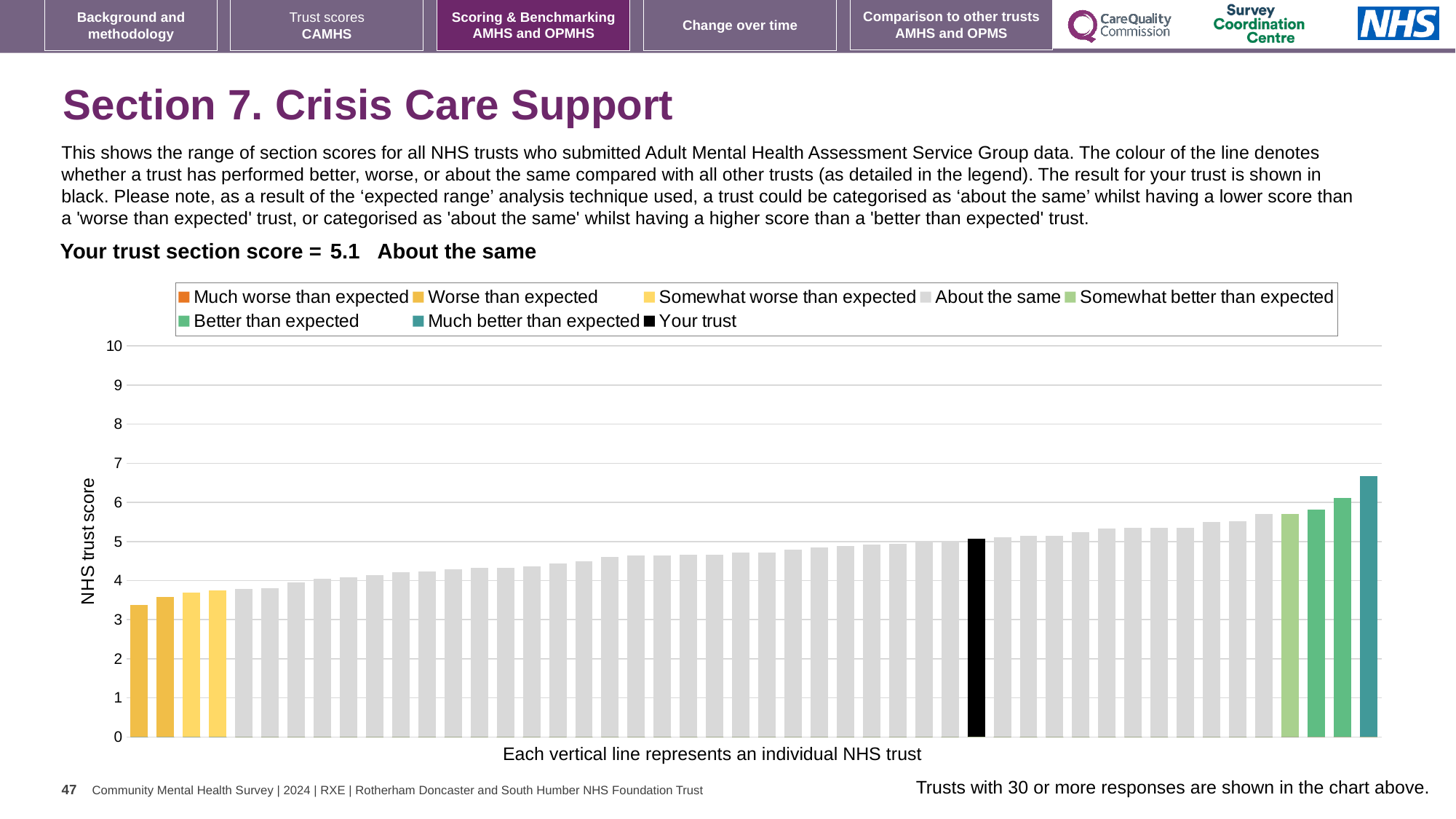
Do the bar values rise or fall from left to right across the chart? rise What is the trust's section score shown on the slide? 5.1 What is the highest value shown on the vertical axis? 10 How many bars in the chart are coloured black? 1 Is the value of the shortest bar greater or less than 4? less Is the value of the tallest bar greater or less than 6? greater How many entries does the chart legend list? 8 Is the value of the black 'Your trust' bar greater or less than 6? less What is the label on the vertical axis of the chart? NHS trust score What kind of chart is shown on the slide? bar chart Which bar is taller, the leftmost bar or the rightmost bar? the rightmost bar